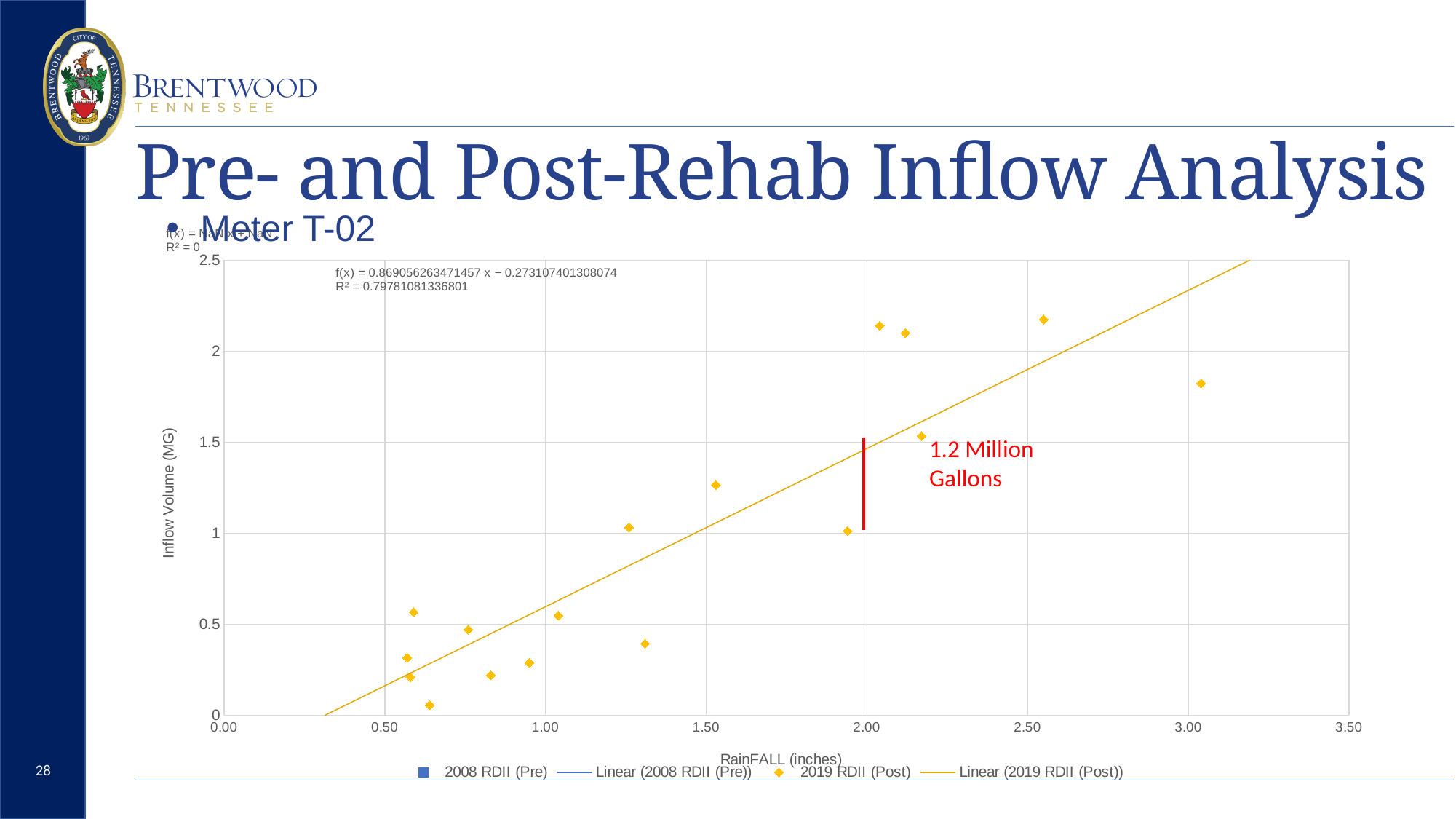
What is the title of the x axis of the chart? RainFALL (inches) What is the maximum value shown on the x axis of the chart? 3.50 What is the maximum value shown on the y axis of the chart? 2.5 Is the inflow volume for the 2019 RDII (Post) point at about 3.0 inches of rainfall greater or less than 1.5? greater What R² value is printed for the 2019 RDII (Post) trendline? 0.79781081336801 Do the 2019 RDII (Post) inflow volumes generally rise or fall as rainfall increases? rise What kind of chart is shown on the slide? scatter chart What is the slope coefficient in the trendline equation printed on the chart? 0.869056263471457 What is the title of the y axis of the chart? Inflow Volume (MG) Is the inflow volume for the lowest 2019 RDII (Post) point greater or less than 0.5? less Is the inflow volume for the 2019 RDII (Post) point at about 1.5 inches of rainfall greater or less than 1? greater How many entries does the chart legend list? 4